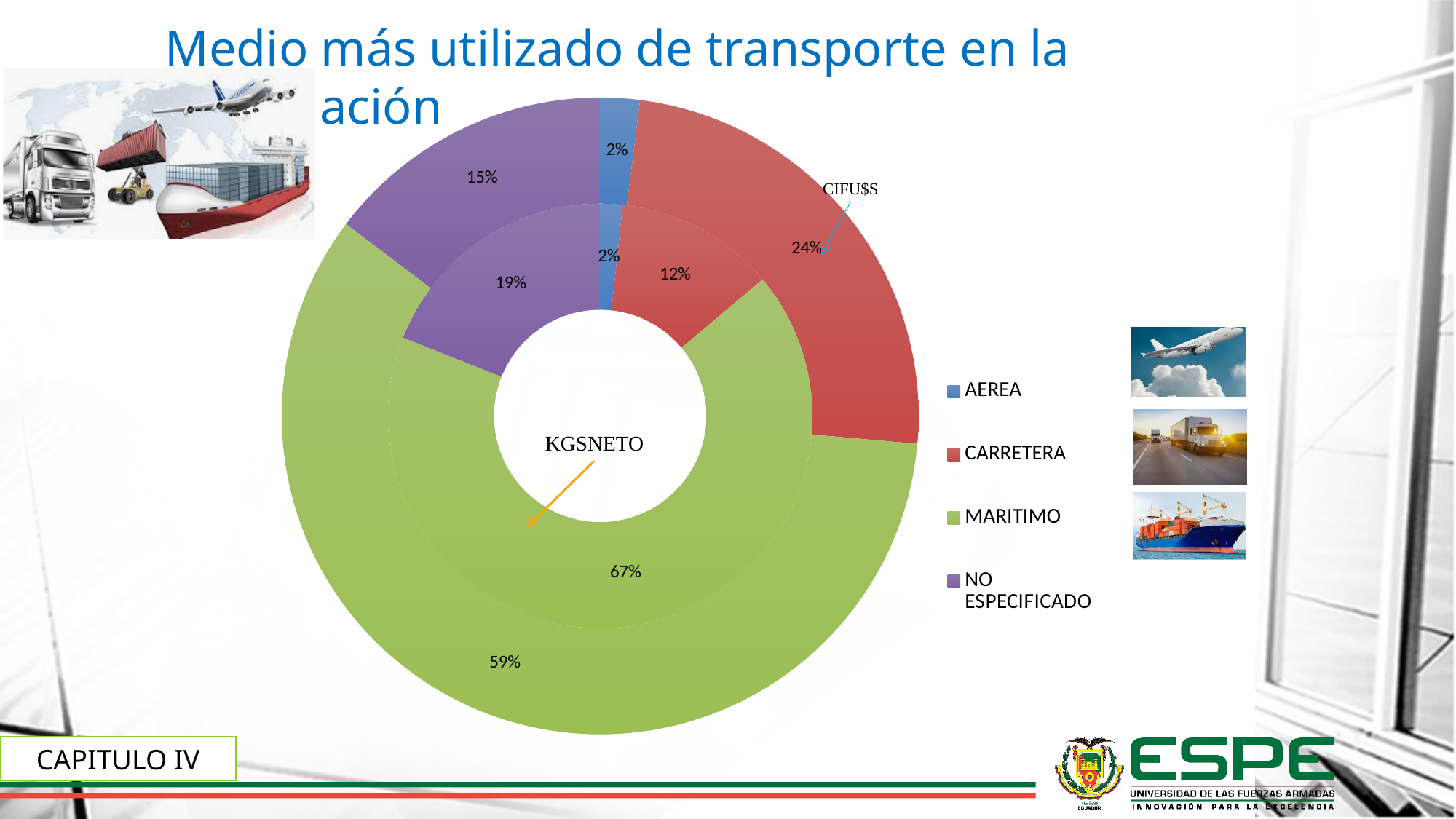
Which category has the largest share in the outer ring (CIFU$S)? MARITIMO In the outer ring (CIFU$S), what share does MARITIMO have? 59% What kind of chart is shown on the slide? doughnut chart How many categories does the legend of the chart list? 4 In the outer ring (CIFU$S), what share does CARRETERA have? 24% Which is larger: the NO ESPECIFICADO share in the inner ring (KGSNETO) or in the outer ring (CIFU$S)? inner ring (KGSNETO) In the inner ring (KGSNETO), what share does MARITIMO have? 67% In the inner ring (KGSNETO), what share does NO ESPECIFICADO have? 19% What is the difference between the CARRETERA share in the outer ring (CIFU$S) and in the inner ring (KGSNETO)? 12% Which category has the smallest share in the inner ring (KGSNETO)? AEREA In the inner ring (KGSNETO), what share does CARRETERA have? 12% In the outer ring (CIFU$S), what share does AEREA have? 2%